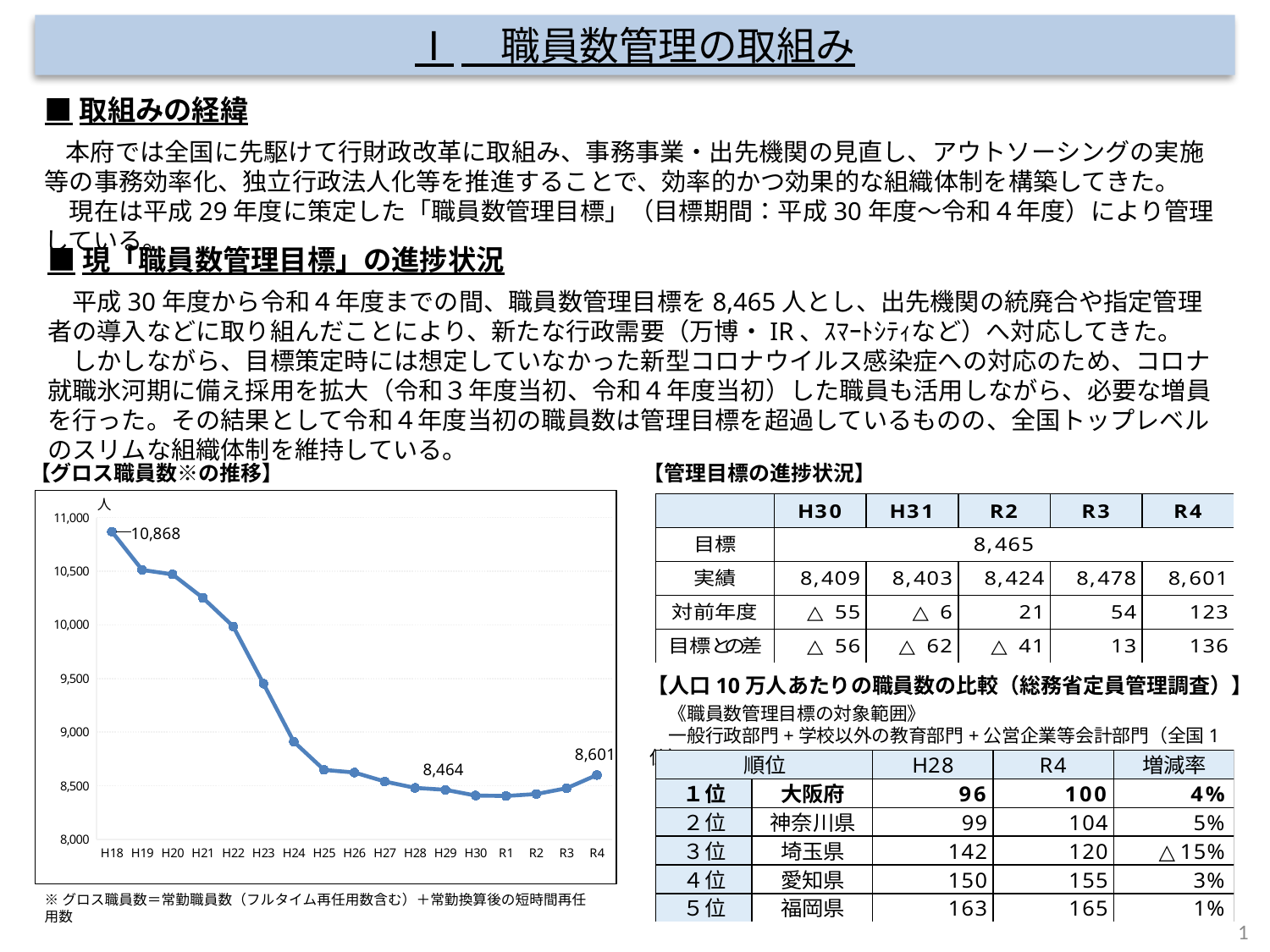
In the 【グロス職員数※の推移】 chart, do the values rise or fall from H18 to H30? fall In the 【グロス職員数※の推移】 chart, which year has the highest value? H18 What kind of chart is shown under 【グロス職員数※の推移】? line chart In the 【グロス職員数※の推移】 chart, is the value for H25 greater or less than 8,500? greater In the 【グロス職員数※の推移】 chart, which is larger, the value for H20 or the value for H21? H20 In the 【グロス職員数※の推移】 chart, what is the difference between the H18 value and the R4 value? 2,267 In the 【グロス職員数※の推移】 chart, what is the value for R4? 8,601 What unit is shown at the top of the y axis in the 【グロス職員数※の推移】 chart? 人 How many data points are plotted in the 【グロス職員数※の推移】 chart? 17 In the 【グロス職員数※の推移】 chart, is the value for H23 greater or less than 10,000? less In the 【グロス職員数※の推移】 chart, what is the value for H18? 10,868 In the 【グロス職員数※の推移】 chart, is the value for H21 greater or less than 10,000? greater